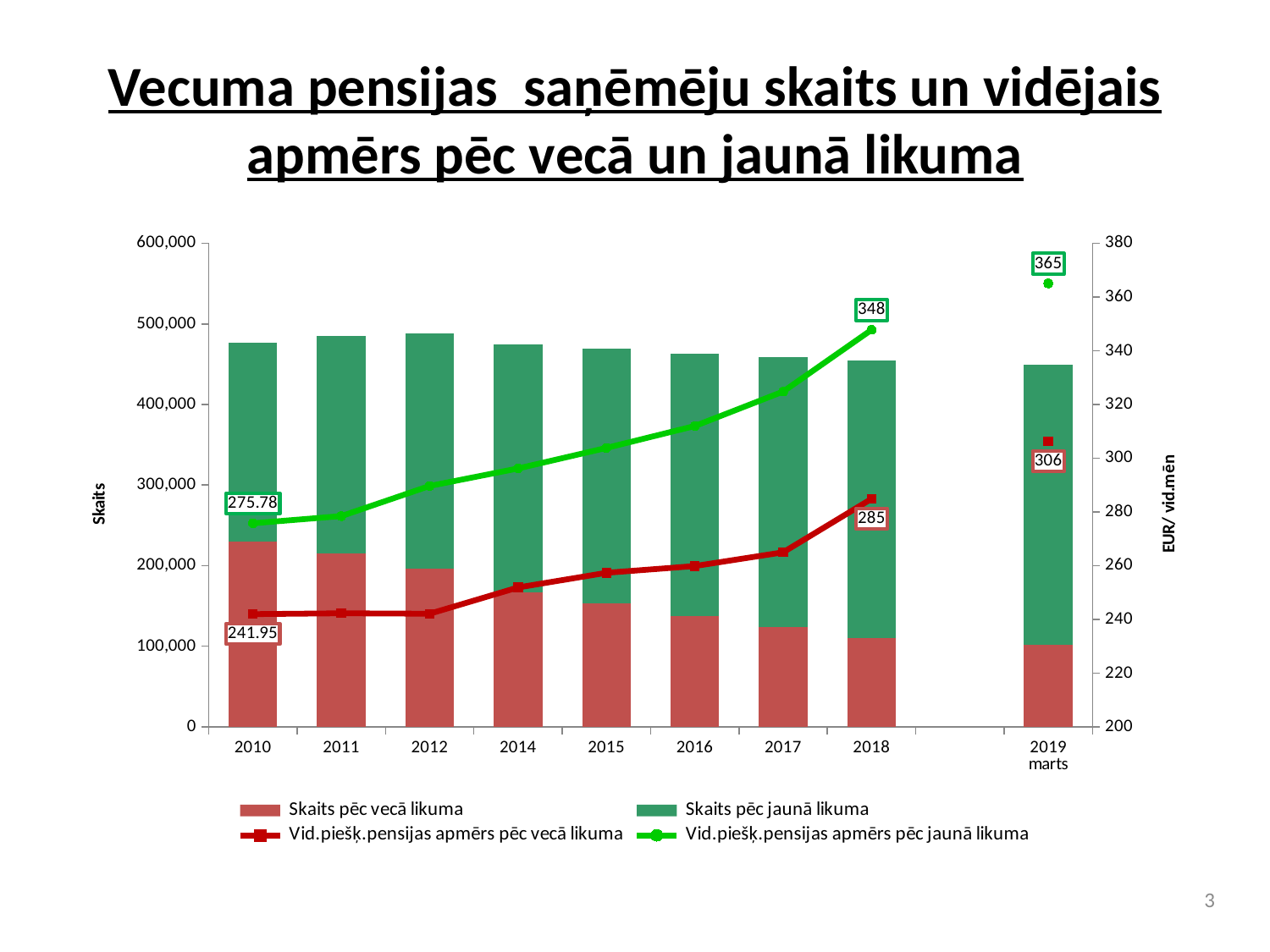
What is the label of the right-hand vertical axis? EUR/ vid.mēn In which period is the Vid.piešķ.pensijas apmērs pēc jaunā likuma value highest? 2019 marts What is the value of Vid.piešķ.pensijas apmērs pēc jaunā likuma in 2018? 348 How many series does the legend list? 4 How many periods are shown on the x axis? 9 What is the value of Vid.piešķ.pensijas apmērs pēc vecā likuma in 2019 marts? 306 What is the value of Vid.piešķ.pensijas apmērs pēc vecā likuma in 2010? 241.95 Is the value for Skaits pēc vecā likuma in 2010 greater or less than 200,000? greater What is the value of Vid.piešķ.pensijas apmērs pēc jaunā likuma in 2010? 275.78 What is the difference between the Vid.piešķ.pensijas apmērs pēc jaunā likuma and pēc vecā likuma values in 2018? 63 Does the Vid.piešķ.pensijas apmērs pēc jaunā likuma line rise or fall from 2010 to 2019 marts? rise What is the difference between the Vid.piešķ.pensijas apmērs pēc jaunā likuma and pēc vecā likuma values in 2019 marts? 59